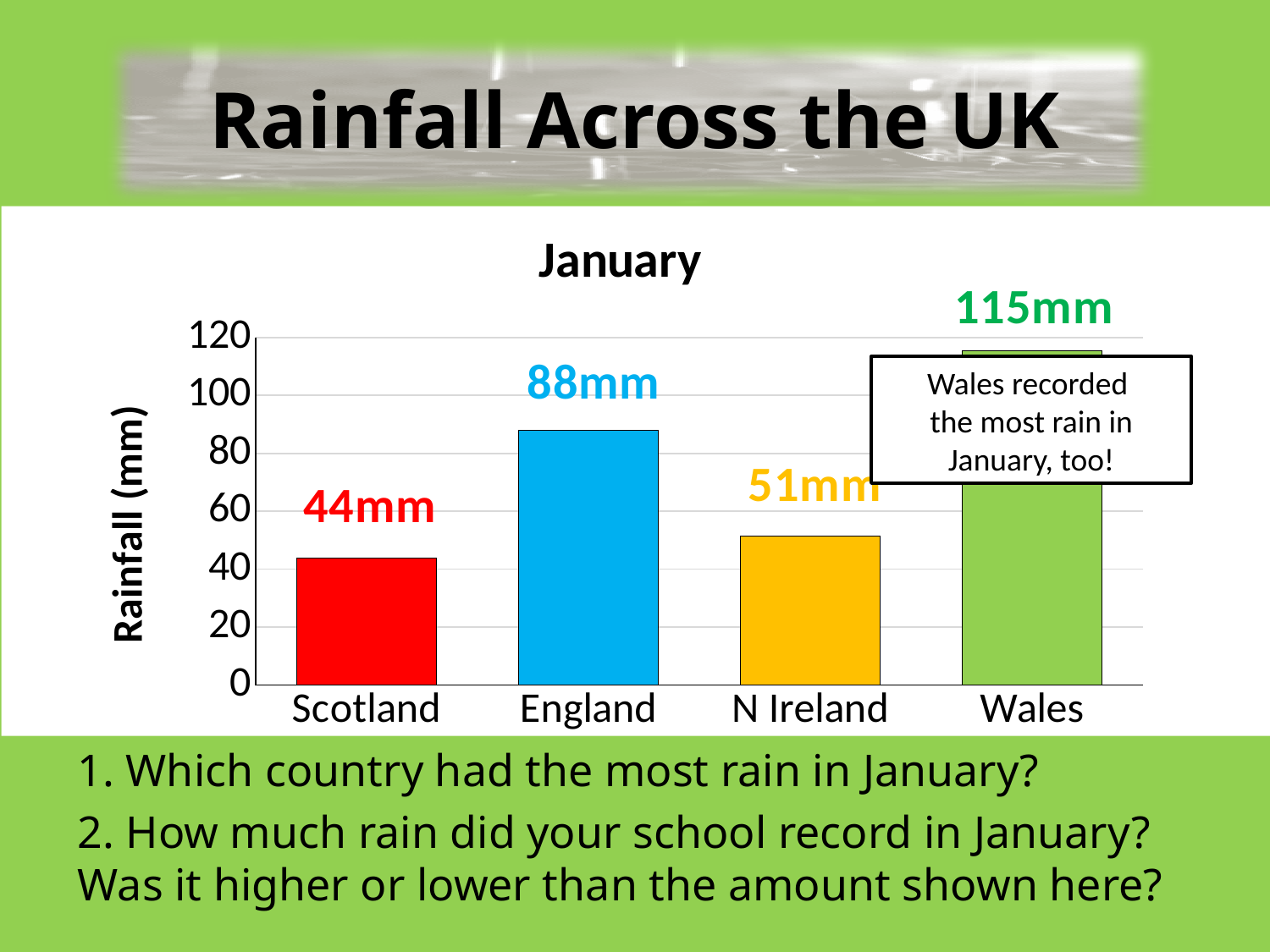
What is the difference in rainfall between England and N Ireland? 37mm What is the difference in rainfall between Wales and Scotland? 71mm Which country recorded the most rainfall in January? Wales What is the title of the chart? January What was the rainfall for N Ireland in January? 51mm How many countries are shown on the chart? 4 Which country recorded the least rainfall in January? Scotland What was the rainfall for Scotland in January? 44mm What was the rainfall for Wales in January? 115mm Which had more rainfall in January, England or N Ireland? England What was the rainfall for England in January? 88mm What type of chart is shown on the slide? Bar chart